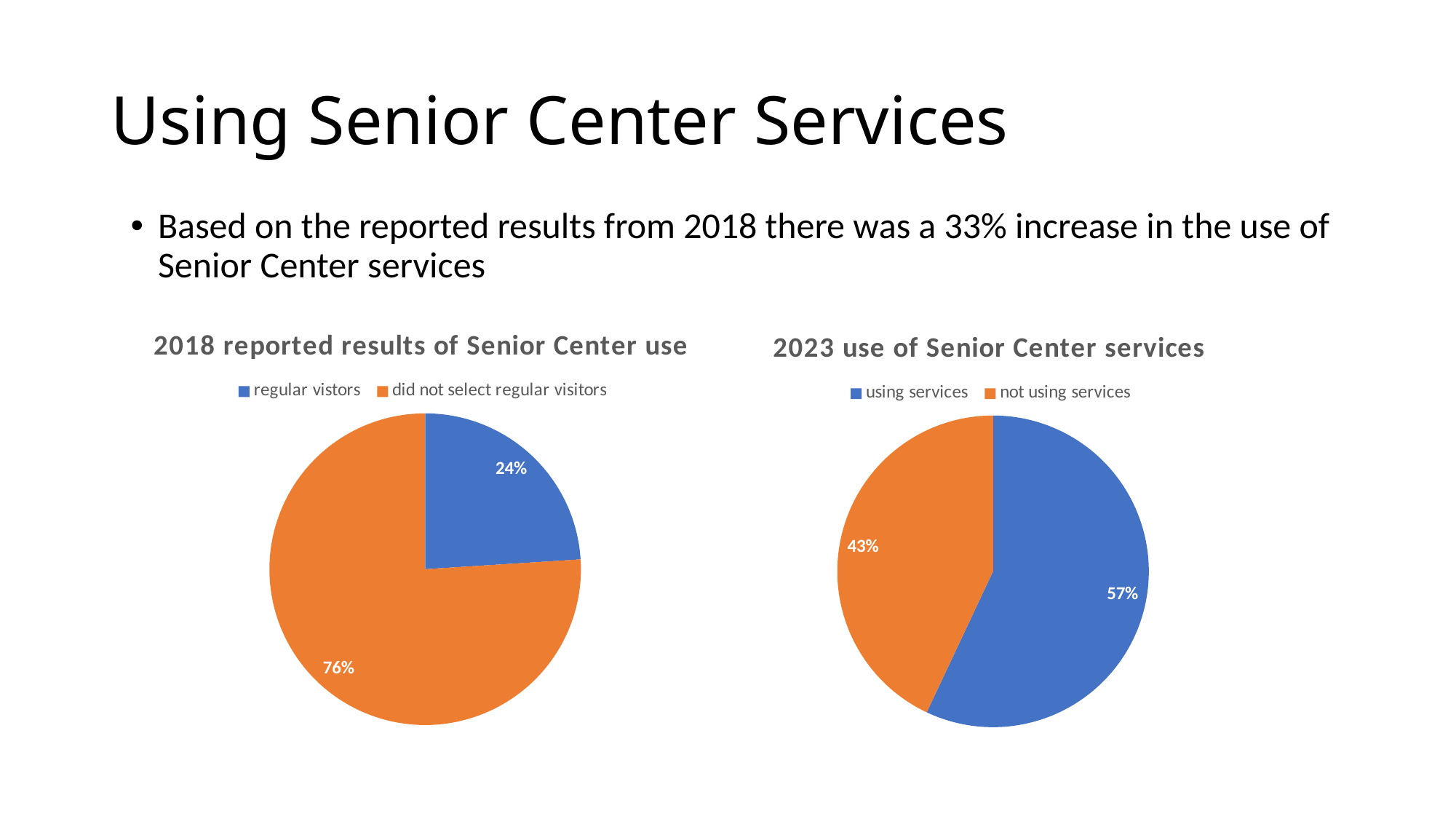
How many slices does the '2023 use of Senior Center services' pie chart have? 2 In the '2023 use of Senior Center services' chart, which is larger, 'using services' or 'not using services'? using services In the '2018 reported results of Senior Center use' chart, what colour is the 'regular vistors' slice? blue What kind of chart is the '2018 reported results of Senior Center use' chart? pie chart In the '2018 reported results of Senior Center use' chart, what share of the pie is 'regular vistors'? 24% In the '2023 use of Senior Center services' chart, what share of the pie is 'not using services'? 43% In the '2018 reported results of Senior Center use' chart, which slice is the largest? did not select regular visitors In the '2023 use of Senior Center services' chart, what share of the pie is 'using services'? 57% In the '2023 use of Senior Center services' chart, which slice is the smallest? not using services In the '2023 use of Senior Center services' chart, what is the difference between the 'using services' and 'not using services' slices? 14% In the '2018 reported results of Senior Center use' chart, what is the difference between the 'did not select regular visitors' and 'regular vistors' slices? 52%